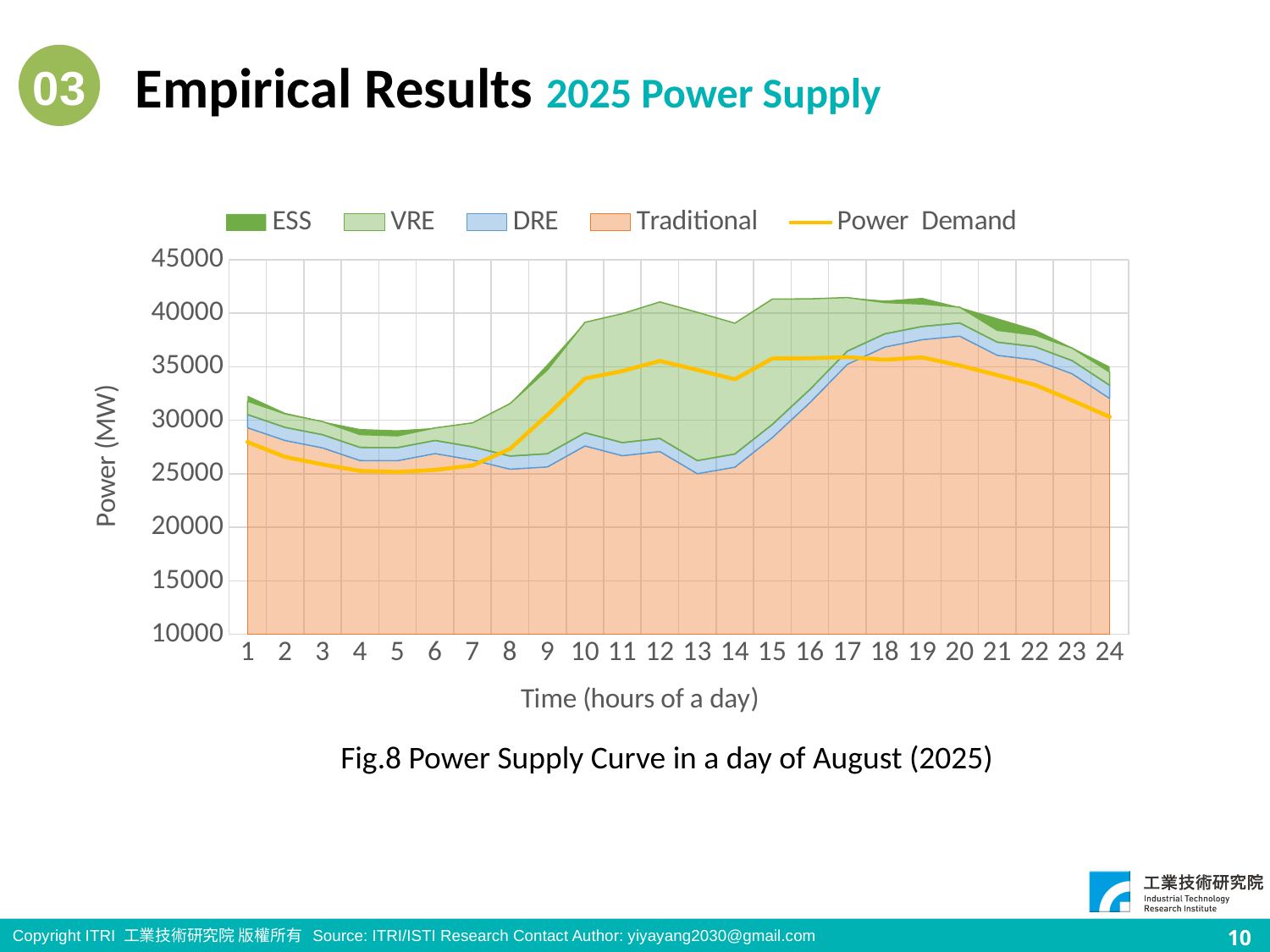
Is the total stacked supply at hour 12 greater or less than 40000? greater How many series does the chart legend list? 5 Is the Power Demand value at hour 19 greater or less than 40000? less Does the Power Demand line rise or fall from hour 19 to hour 24? fall How many hours (points) are shown along the x axis of the chart? 24 Is the Power Demand value at hour 1 greater or less than 30000? less What kind of chart is shown on the slide? Stacked area chart with a line for Power Demand What is the label of the y axis of the chart? Power (MW) Does the Power Demand line rise or fall from hour 7 to hour 12? rise Which is larger, the Power Demand at hour 10 or at hour 1? hour 10